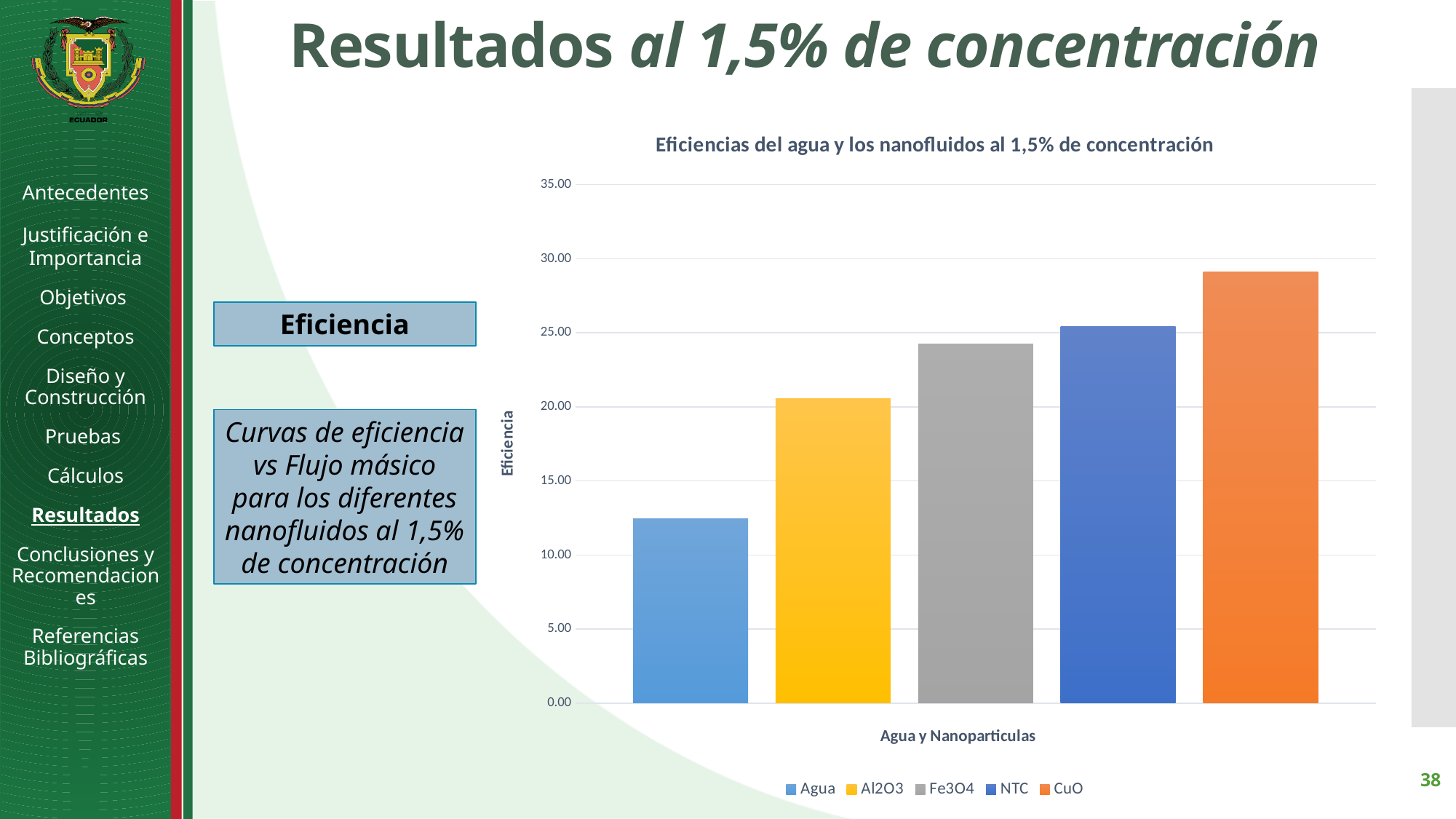
How many entries does the chart legend list? 5 What kind of chart is shown on the slide? bar chart Is the value for CuO greater or less than 30? less Which has a higher efficiency, Agua or Al2O3? Al2O3 How many bars are plotted in the chart? 5 Is the value for Fe3O4 greater or less than 25? less Is the value for Agua greater or less than 15? less Which has a higher efficiency, NTC or CuO? CuO Which category has the lowest efficiency in the chart? Agua What is the label of the vertical axis of the chart? Eficiencia Which category has the highest efficiency in the chart? CuO What is the title of the chart? Eficiencias del agua y los nanofluidos al 1,5% de concentración